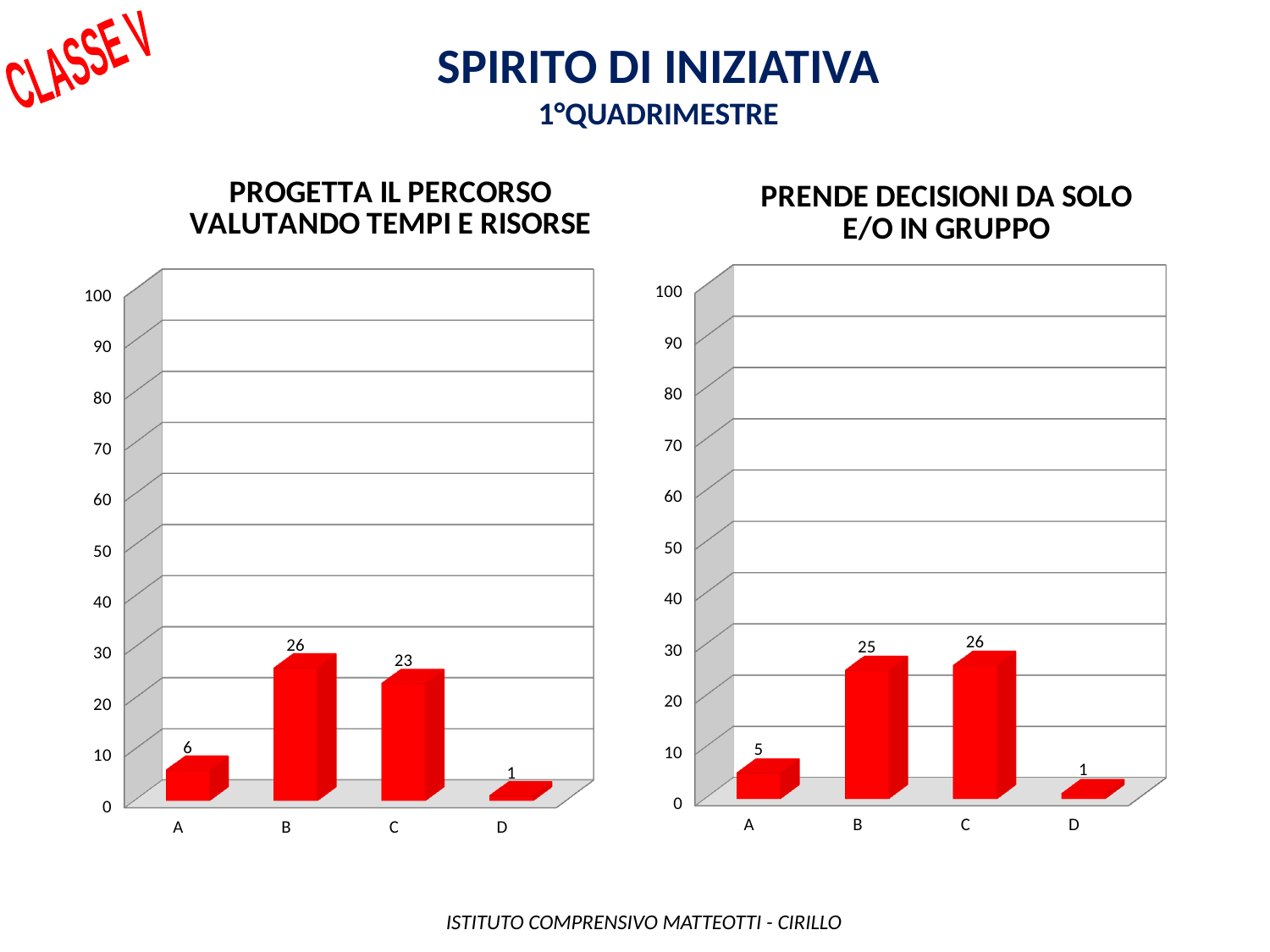
In the right chart, which category has the lowest value? D In the left chart, which category has the highest value? B How many categories are shown on the x axis of the left chart? 4 What is the title of the left chart? PROGETTA IL PERCORSO VALUTANDO TEMPI E RISORSE In the chart titled "PROGETTA IL PERCORSO VALUTANDO TEMPI E RISORSE", what is the value for category B? 26 What kind of chart is the chart titled "PRENDE DECISIONI DA SOLO E/O IN GRUPPO"? bar chart In the left chart, what is the difference between the values for B and C? 3 In the chart titled "PRENDE DECISIONI DA SOLO E/O IN GRUPPO", what is the value for category A? 5 In the right chart, what is the difference between the values for C and A? 21 In the right chart, is the value for B greater or less than 20? greater In the right chart, what is the value for category D? 1 In the left chart, which is larger, the value for A or the value for C? C